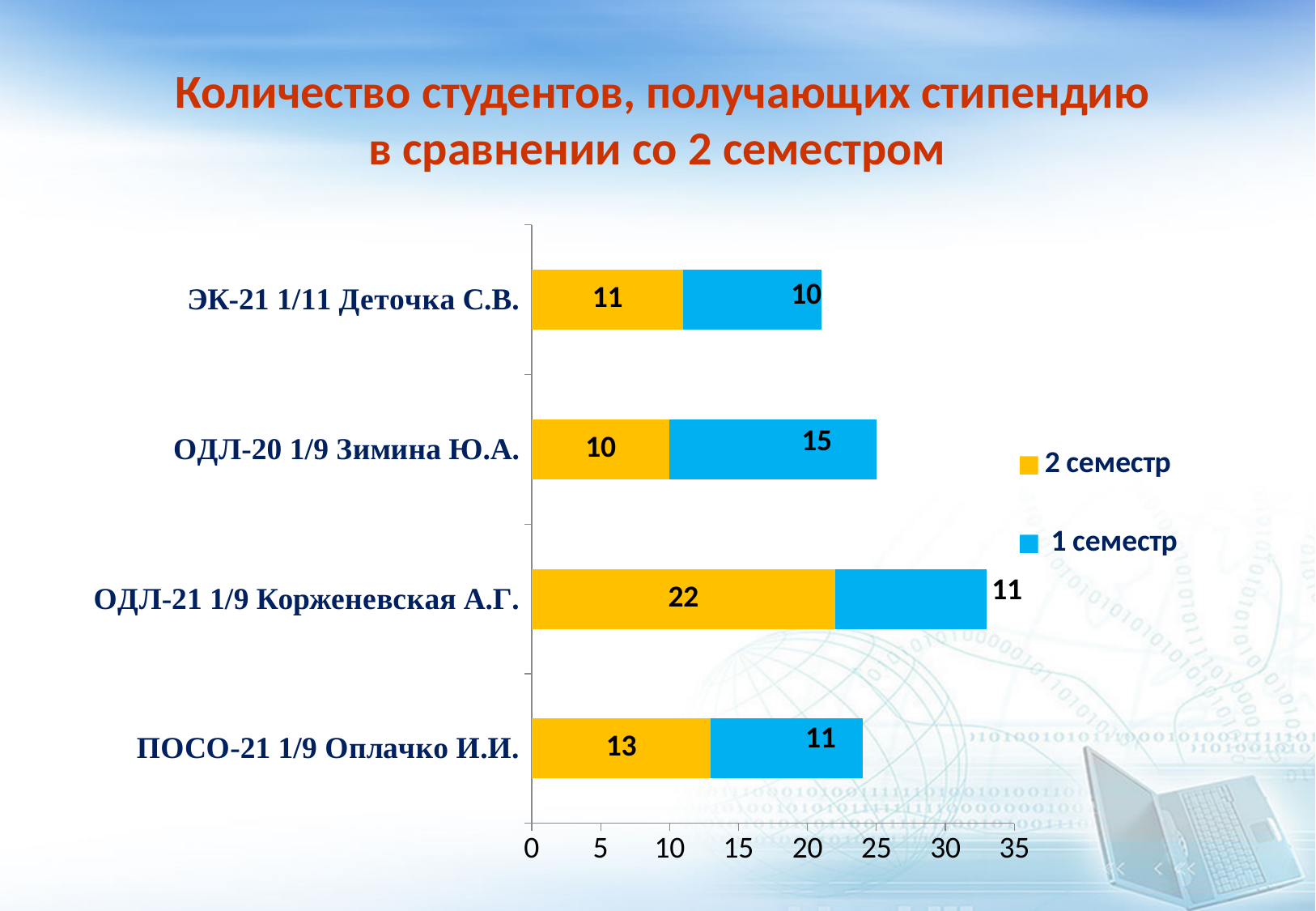
How many categories (groups) are shown on the chart? 4 What type of chart is shown on the slide? stacked bar chart What is the total of the stacked bar for ОДЛ-21 1/9 Корженевская А.Г.? 33 For ОДЛ-20 1/9 Зимина Ю.А., which is larger: the "1 семестр" value or the "2 семестр" value? 1 семестр What is the difference between the "2 семестр" and "1 семестр" values for ОДЛ-21 1/9 Корженевская А.Г.? 11 Which category has the lowest value for "2 семестр"? ОДЛ-20 1/9 Зимина Ю.А. What is the value for "2 семестр" for ОДЛ-21 1/9 Корженевская А.Г.? 22 How many series does the legend list? 2 Which category has the highest value for "2 семестр"? ОДЛ-21 1/9 Корженевская А.Г. What is the value for "2 семестр" for ПОСО-21 1/9 Оплачко И.И.? 13 What is the value for "1 семестр" for ОДЛ-20 1/9 Зимина Ю.А.? 15 Which colour represents "1 семестр" in the legend? blue